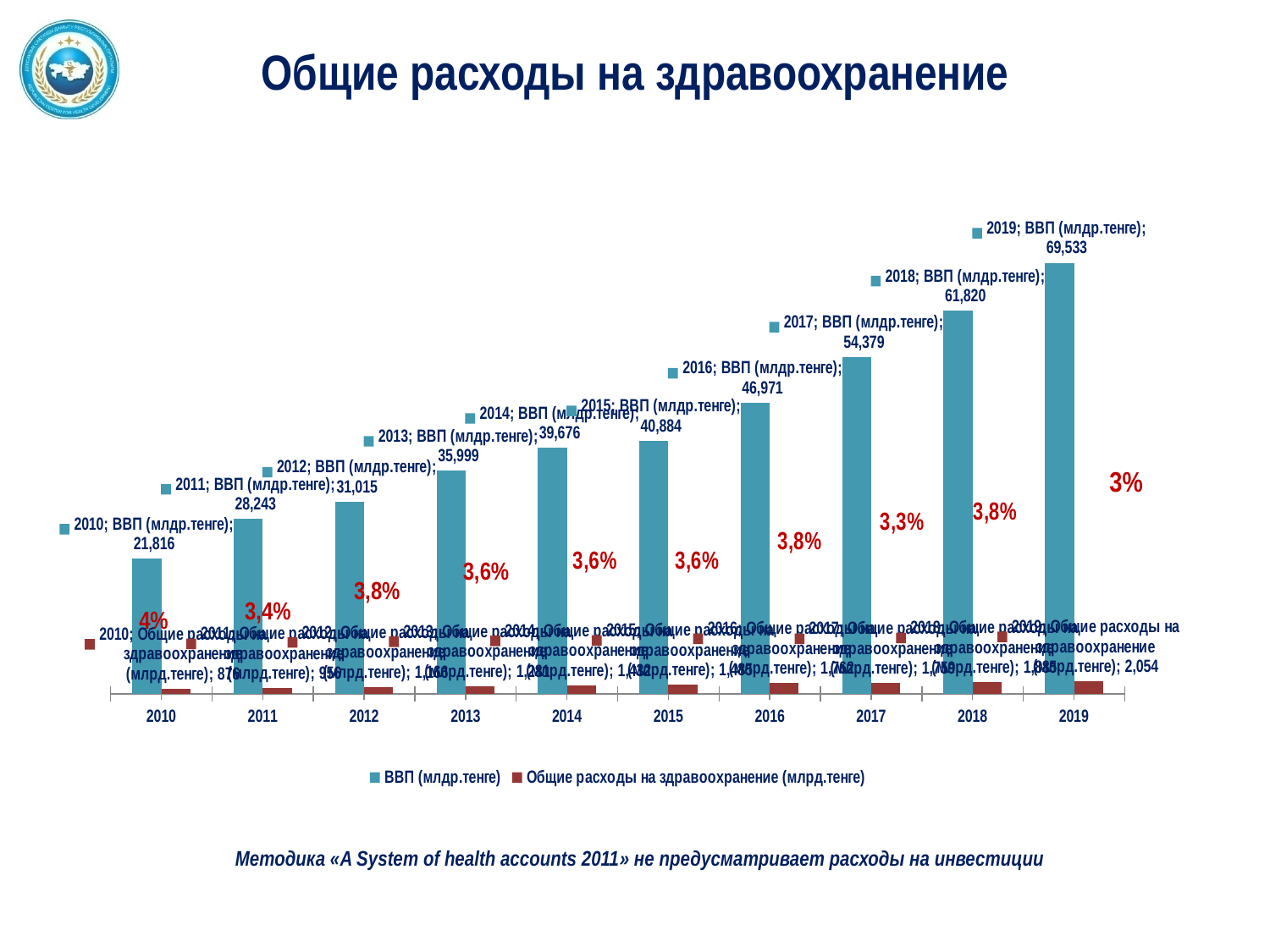
What is the value of ВВП (млдр.тенге) for 2010? 21,816 What kind of chart is shown on the slide? Bar chart Which year has the highest ВВП (млдр.тенге) value? 2019 What is the difference between the ВВП (млдр.тенге) values for 2019 and 2018? 7,713 How many years are shown on the x axis of the chart? 10 Which year has the lowest ВВП (млдр.тенге) value? 2010 Do the ВВП (млдр.тенге) values rise or fall from 2010 to 2019? Rise How many series does the legend list? 2 Which is larger, the ВВП (млдр.тенге) value for 2013 or for 2016? 2016 What is the value of ВВП (млдр.тенге) for 2019? 69,533 What is the value of ВВП (млдр.тенге) for 2017? 54,379 What is the value of ВВП (млдр.тенге) for 2015? 40,884